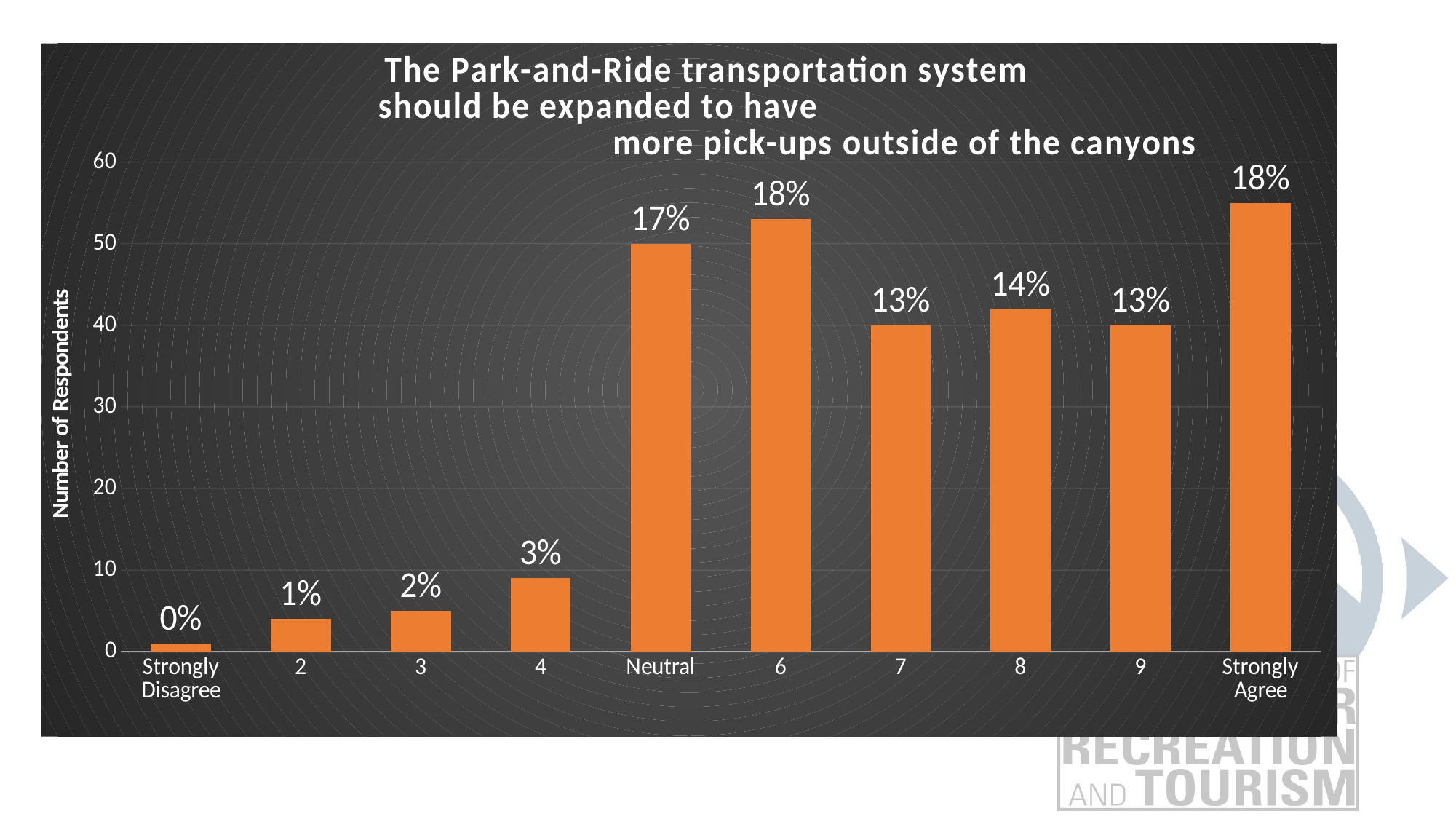
Which has the larger value, category 8 or category 7? 8 What percentage label is shown for category 8? 14% Is the number of respondents for category 4 greater or less than 20? less What is the label of the vertical axis of the chart? Number of Respondents What percentage label is shown for the Strongly Disagree category? 0% What is the difference in percentage points between the labels for Neutral and category 7? 4 What percentage label is shown for the Neutral category? 17% What percentage label is shown for the Strongly Agree category? 18% How many categories are shown on the x axis of the chart? 10 Is the number of respondents for Neutral greater or less than 40? greater What kind of chart is shown on the slide? bar chart Which category has the lowest value in the chart? Strongly Disagree